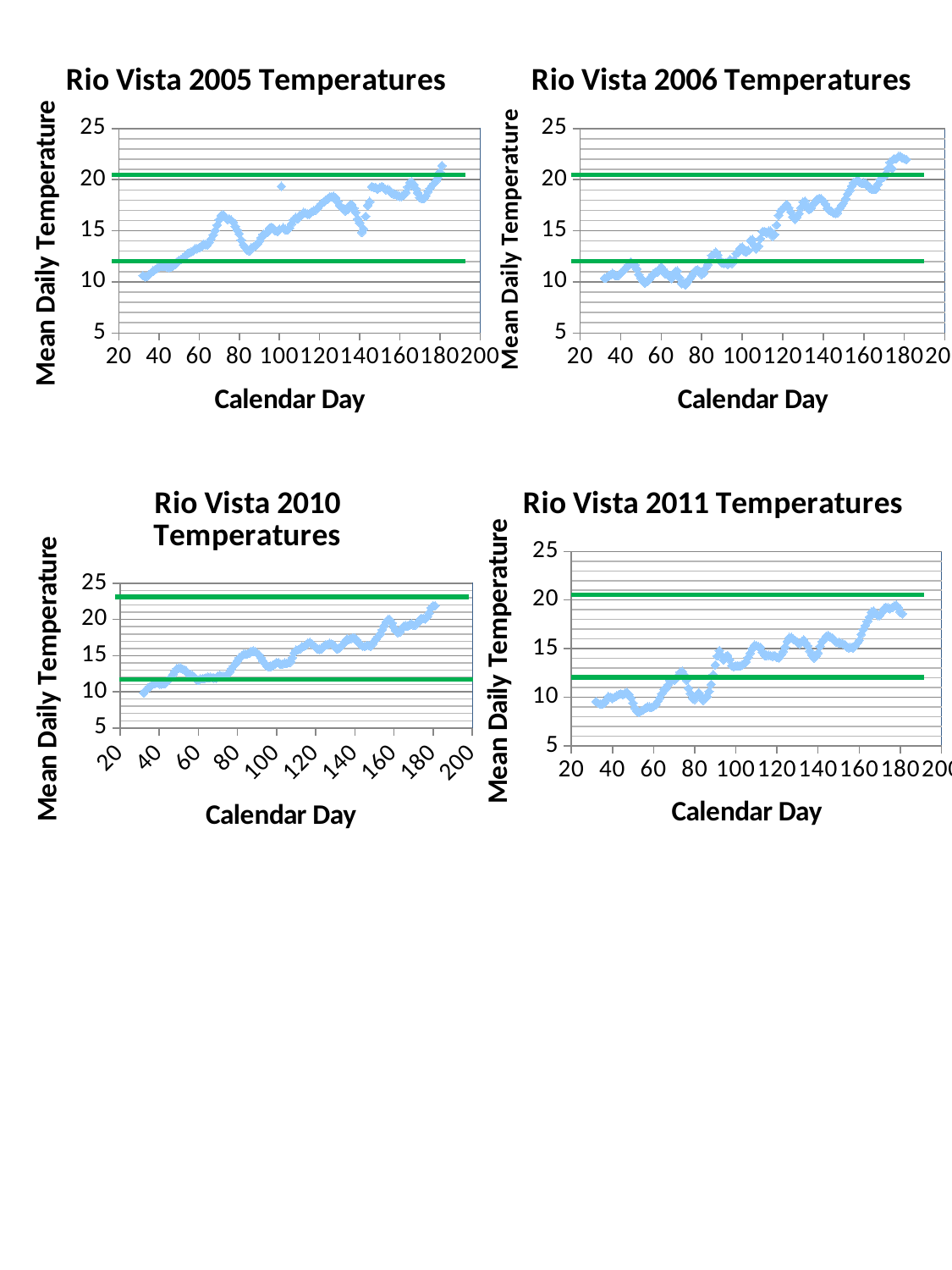
In the Rio Vista 2006 Temperatures chart, do the temperatures generally rise or fall as the calendar day increases? rise In the Rio Vista 2005 Temperatures chart, is the value at calendar day 40 greater or less than 15? less In the Rio Vista 2011 Temperatures chart, is the value at calendar day 60 greater or less than 10? less In the Rio Vista 2006 Temperatures chart, is the value at calendar day 180 greater or less than 20? greater In the Rio Vista 2005 Temperatures chart, which is larger: the value at calendar day 40 or the value at calendar day 180? calendar day 180 In the Rio Vista 2011 Temperatures chart, do the temperatures generally rise or fall from day 40 to day 180? rise What kind of chart is the Rio Vista 2005 Temperatures chart? scatter chart At calendar day 180, which chart shows the larger value: Rio Vista 2006 Temperatures or Rio Vista 2011 Temperatures? Rio Vista 2006 Temperatures What is the y-axis label of the Rio Vista 2010 Temperatures chart? Mean Daily Temperature How many charts are shown on the slide? 4